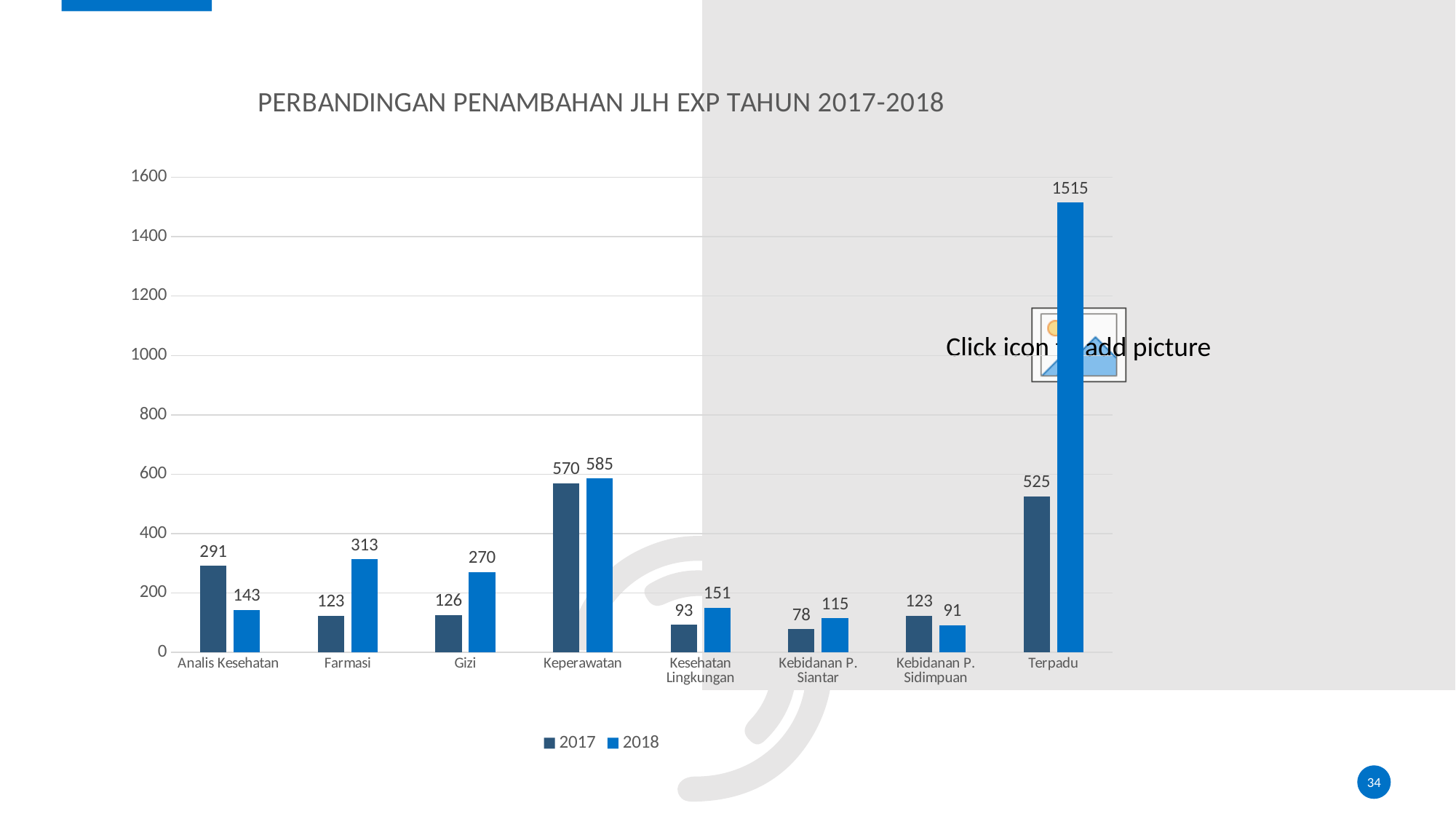
What is the difference between the 2018 and 2017 values for Terpadu? 990 Is the 2018 value for Keperawatan greater or less than 400? greater Which is larger for Kebidanan P. Sidimpuan, the 2017 value or the 2018 value? 2017 What is the title of the chart? PERBANDINGAN PENAMBAHAN JLH EXP TAHUN 2017-2018 What is the 2018 value for Terpadu? 1515 What kind of chart is shown on the slide? bar chart How many categories are shown on the x axis? 8 How many series does the legend list? 2 Which category has the highest 2017 value? Keperawatan What is the 2017 value for Analis Kesehatan? 291 What is the 2018 value for Kebidanan P. Siantar? 115 Which category has the lowest 2017 value? Kebidanan P. Siantar